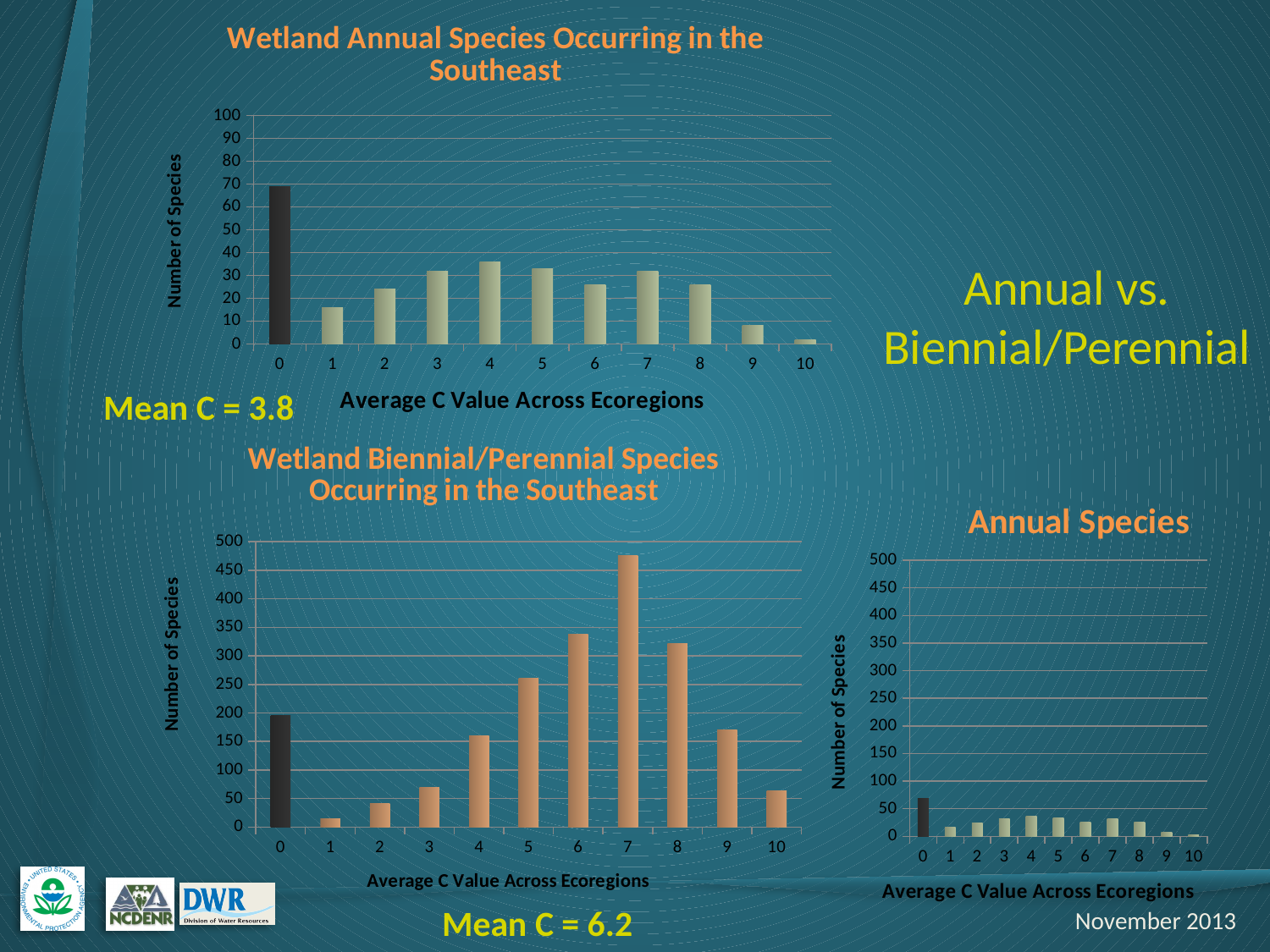
In the 'Wetland Annual Species Occurring in the Southeast' chart, which C value has the highest number of species? 0 In the 'Wetland Biennial/Perennial Species Occurring in the Southeast' chart, which has more species: C value 5 or C value 8? 8 What Mean C value is shown below the 'Wetland Biennial/Perennial Species Occurring in the Southeast' chart? 6.2 In the 'Wetland Annual Species Occurring in the Southeast' chart, which C value has the lowest number of species? 10 In the 'Wetland Biennial/Perennial Species Occurring in the Southeast' chart, is the value for C value 7 greater or less than 450? greater In the 'Wetland Annual Species Occurring in the Southeast' chart, how many C value categories are shown on the x axis? 11 In the 'Wetland Annual Species Occurring in the Southeast' chart, is the value for C value 0 greater or less than 60? greater In the 'Wetland Biennial/Perennial Species Occurring in the Southeast' chart, which C value has the lowest number of species? 1 In the 'Annual Species' chart at the bottom right, is the value for C value 0 greater or less than 100? less In the 'Wetland Biennial/Perennial Species Occurring in the Southeast' chart, which C value has the highest number of species? 7 What kind of chart is the 'Wetland Annual Species Occurring in the Southeast' chart? bar chart